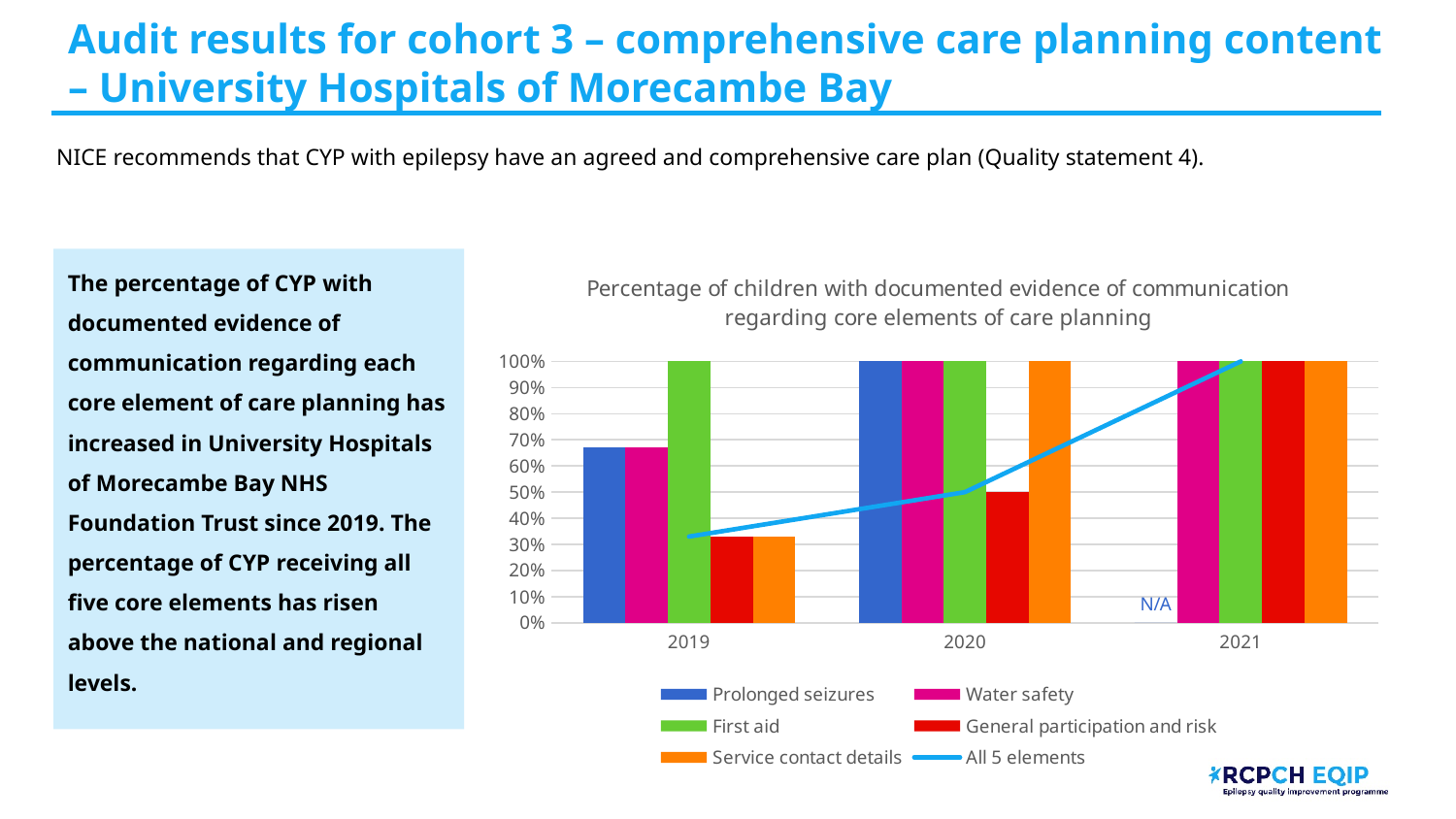
What kind of chart is shown on the slide? bar chart with a line How many series does the legend list? 6 Is the value for Prolonged seizures in 2019 greater or less than 60%? greater Does the All 5 elements line rise or fall from 2019 to 2021? rise Which is larger in 2019: First aid or General participation and risk? First aid What is the value for General participation and risk in 2020? 50% Which series has the lowest value in 2020? General participation and risk and All 5 elements (both 50%) What is the value for First aid in 2019? 100% How many years are shown on the x axis? 3 What is shown for Prolonged seizures in 2021? N/A What is the title of the chart? Percentage of children with documented evidence of communication regarding core elements of care planning Is the value for Service contact details in 2019 greater or less than 40%? less